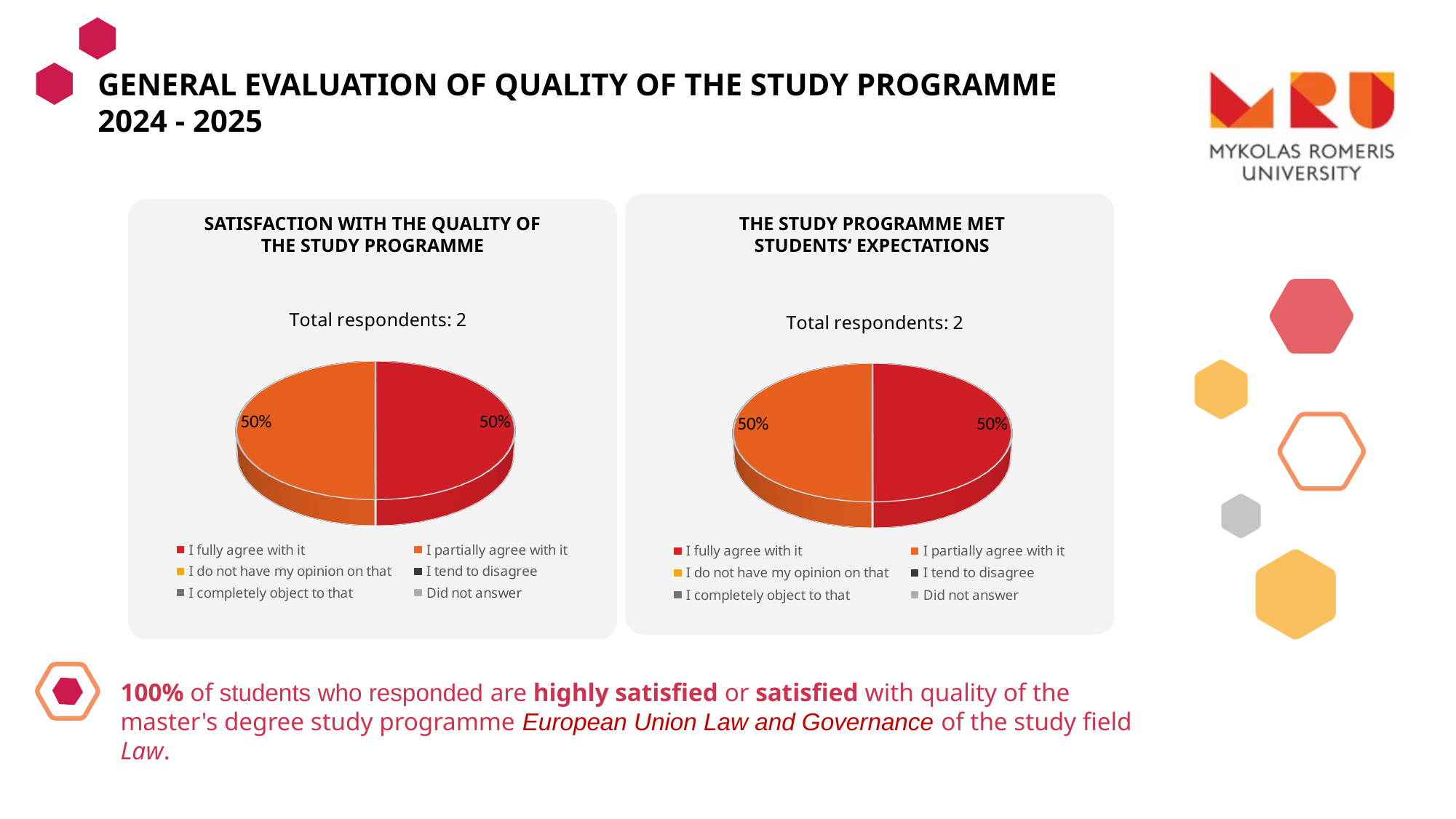
In the 'The study programme met students' expectations' chart, what share of respondents partially agree with it? 50% In the 'Satisfaction with the quality of the study programme' chart, which colour represents 'I fully agree with it'? Red How many legend entries are listed for the 'Satisfaction with the quality of the study programme' chart? 6 How many slices are visible in the 'The study programme met students' expectations' pie chart? 2 In the 'Satisfaction with the quality of the study programme' chart, what share of respondents partially agree with it? 50% What kind of chart is used in the 'The study programme met students' expectations' panel? Pie chart In the 'Satisfaction with the quality of the study programme' chart, what is the difference between the 'I fully agree with it' and 'I partially agree with it' shares? 0% What kind of chart is used in the 'Satisfaction with the quality of the study programme' panel? Pie chart In the 'The study programme met students' expectations' chart, what share of respondents fully agree with it? 50% How many total respondents are reported for the 'The study programme met students' expectations' chart? 2 In the 'The study programme met students' expectations' chart, what is the combined share of 'I fully agree with it' and 'I partially agree with it'? 100% In the 'Satisfaction with the quality of the study programme' chart, what share of respondents fully agree with it? 50%